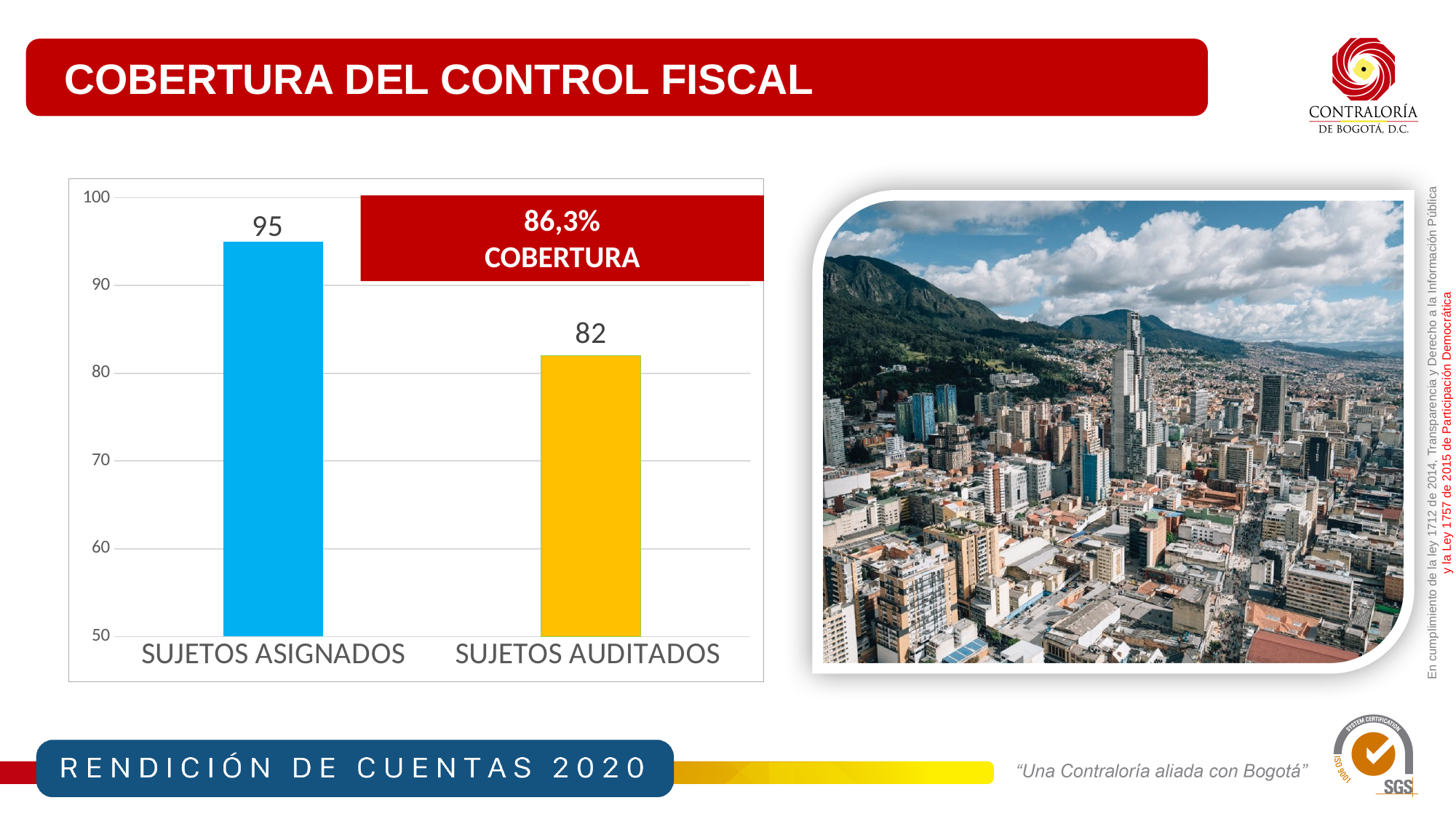
What is the value for SUJETOS ASIGNADOS? 95 Which is larger, the value for SUJETOS ASIGNADOS or the value for SUJETOS AUDITADOS? SUJETOS ASIGNADOS What colour is the bar for SUJETOS AUDITADOS? yellow Which category has the lowest value? SUJETOS AUDITADOS What is the value for SUJETOS AUDITADOS? 82 What coverage percentage is shown in the red box on the chart? 86,3% What kind of chart is shown on the slide? bar chart Is the value for SUJETOS AUDITADOS greater or less than 90? less Is the value for SUJETOS ASIGNADOS greater or less than 90? greater How many categories are shown in the chart? 2 Which category has the highest value? SUJETOS ASIGNADOS What is the difference between the values for SUJETOS ASIGNADOS and SUJETOS AUDITADOS? 13